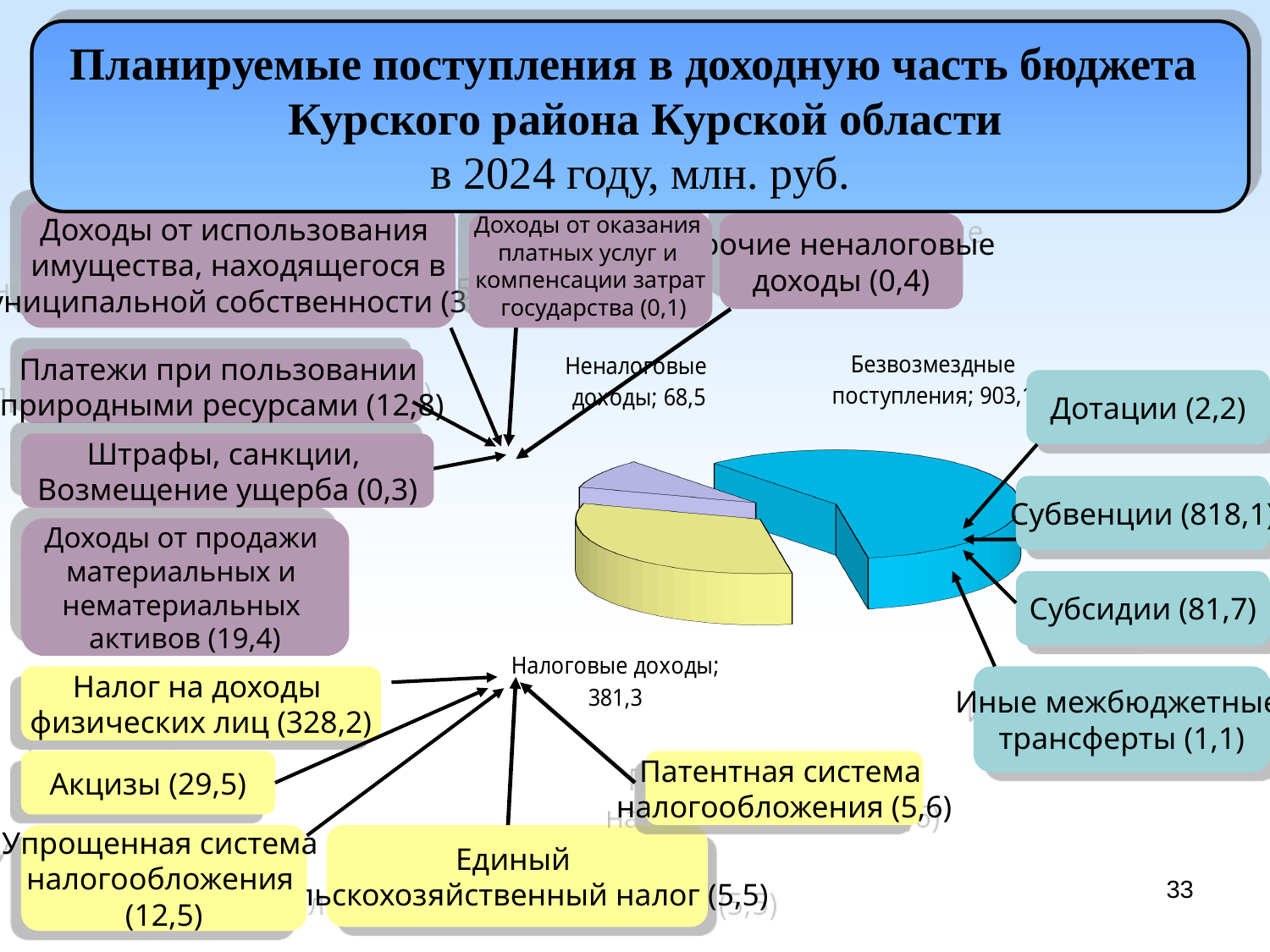
What unit is stated in the slide title for the values in the chart? млн. руб. Which is larger in the pie chart: Налоговые доходы or Неналоговые доходы? Налоговые доходы What colour is the Безвозмездные поступления slice of the pie chart? blue Which slice of the pie chart is the largest? Безвозмездные поступления Which slice of the pie chart is the smallest? Неналоговые доходы How many slices does the pie chart have? 3 What is the difference between the values for Налоговые доходы and Неналоговые доходы in the pie chart? 312,8 What is the value shown for Неналоговые доходы in the pie chart? 68,5 What is the value shown for Налоговые доходы in the pie chart? 381,3 Which is larger in the pie chart: Безвозмездные поступления or Налоговые доходы? Безвозмездные поступления What kind of chart is shown on the slide? pie chart